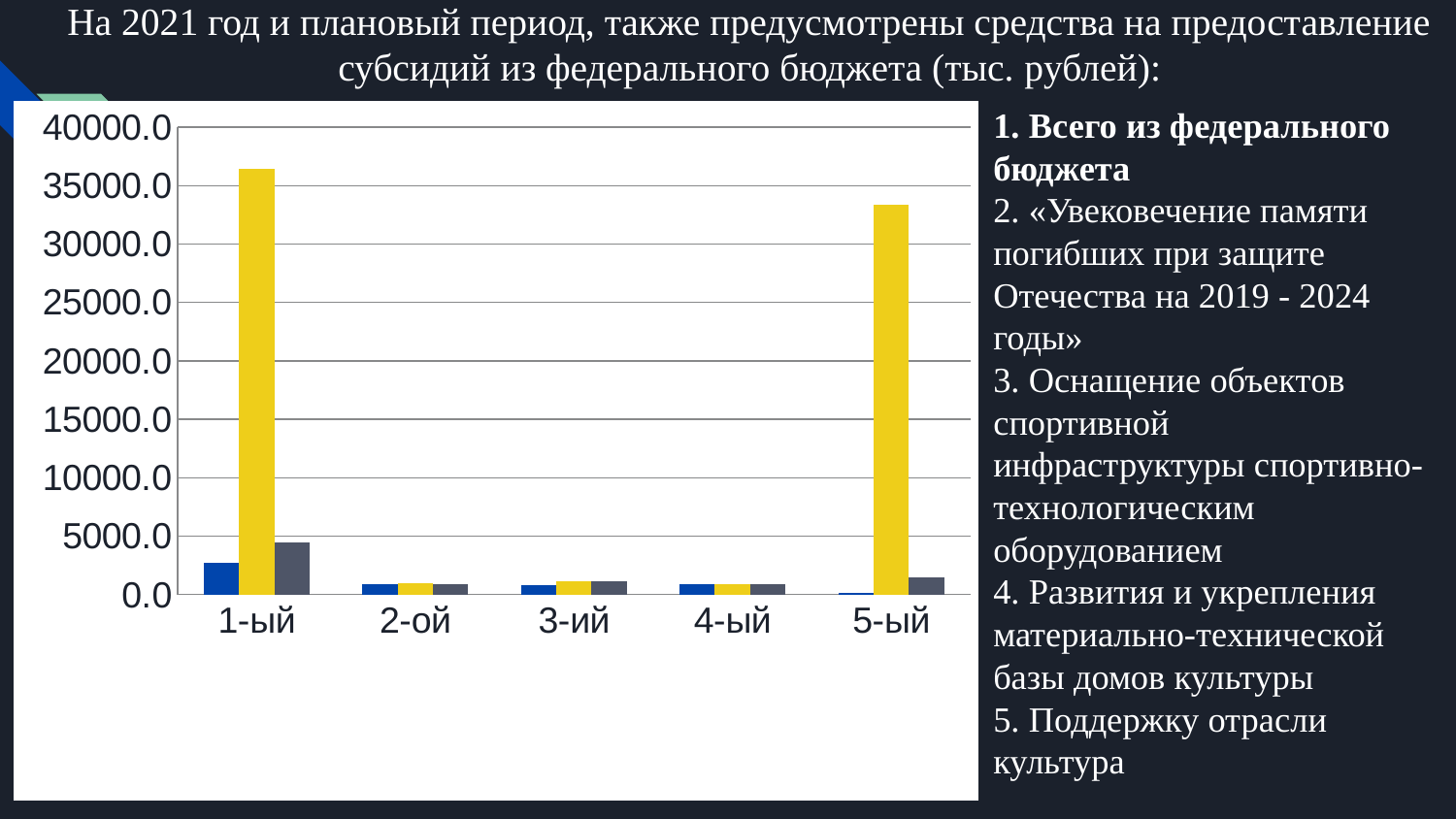
What is the highest value labelled on the y axis of the chart? 40000.0 How many categories are shown on the x axis of the chart? 5 What kind of chart is shown on the slide? bar chart How many bars are plotted for each category in the chart? 3 Which is larger: the yellow bar for 1-ый or the yellow bar for 5-ый? 1-ый Is the value of the gray bar for 1-ый greater or less than 5000.0? less Is the value of the yellow bar for 5-ый greater or less than 30000.0? greater Which category has the tallest yellow bar? 1-ый Is the value of the yellow bar for 1-ый greater or less than 35000.0? greater Which category has the tallest bar overall in the chart? 1-ый